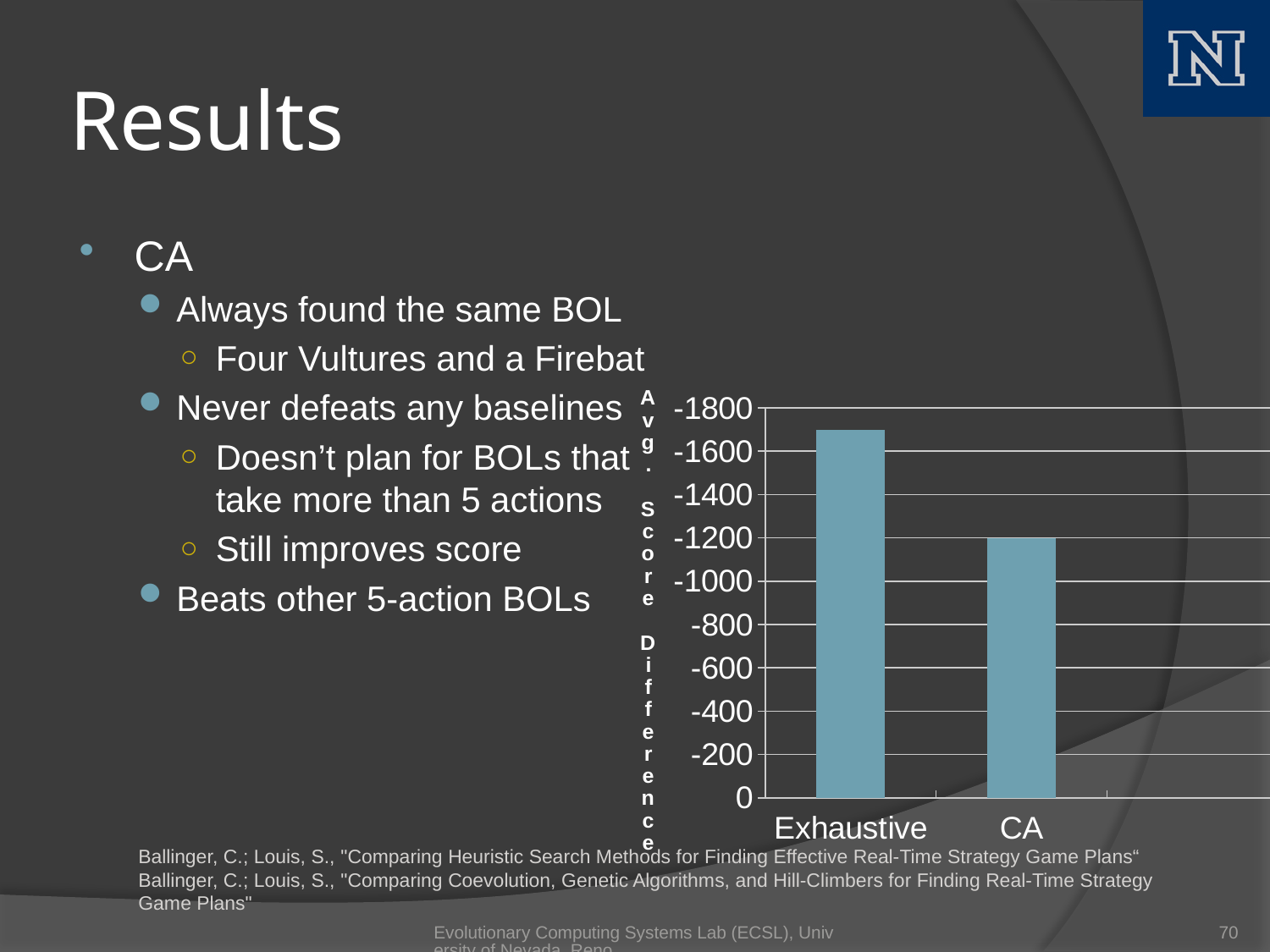
Is the value for CA greater or less than -1400? greater Does the bar height rise or fall going from Exhaustive to CA along the x axis? fall Which category has the taller bar in the chart? Exhaustive Is the value for Exhaustive greater or less than -1600? less Which category has the shorter bar in the chart? CA What kind of chart is shown on the slide? bar chart What are the two categories on the x axis of the chart? Exhaustive and CA What is the value for CA in the chart? -1200 What is the lowest tick value shown at the top of the vertical axis? -1800 How many categories are shown on the x axis of the chart? 2 What is the title of the vertical axis of the chart? Avg. Score Difference